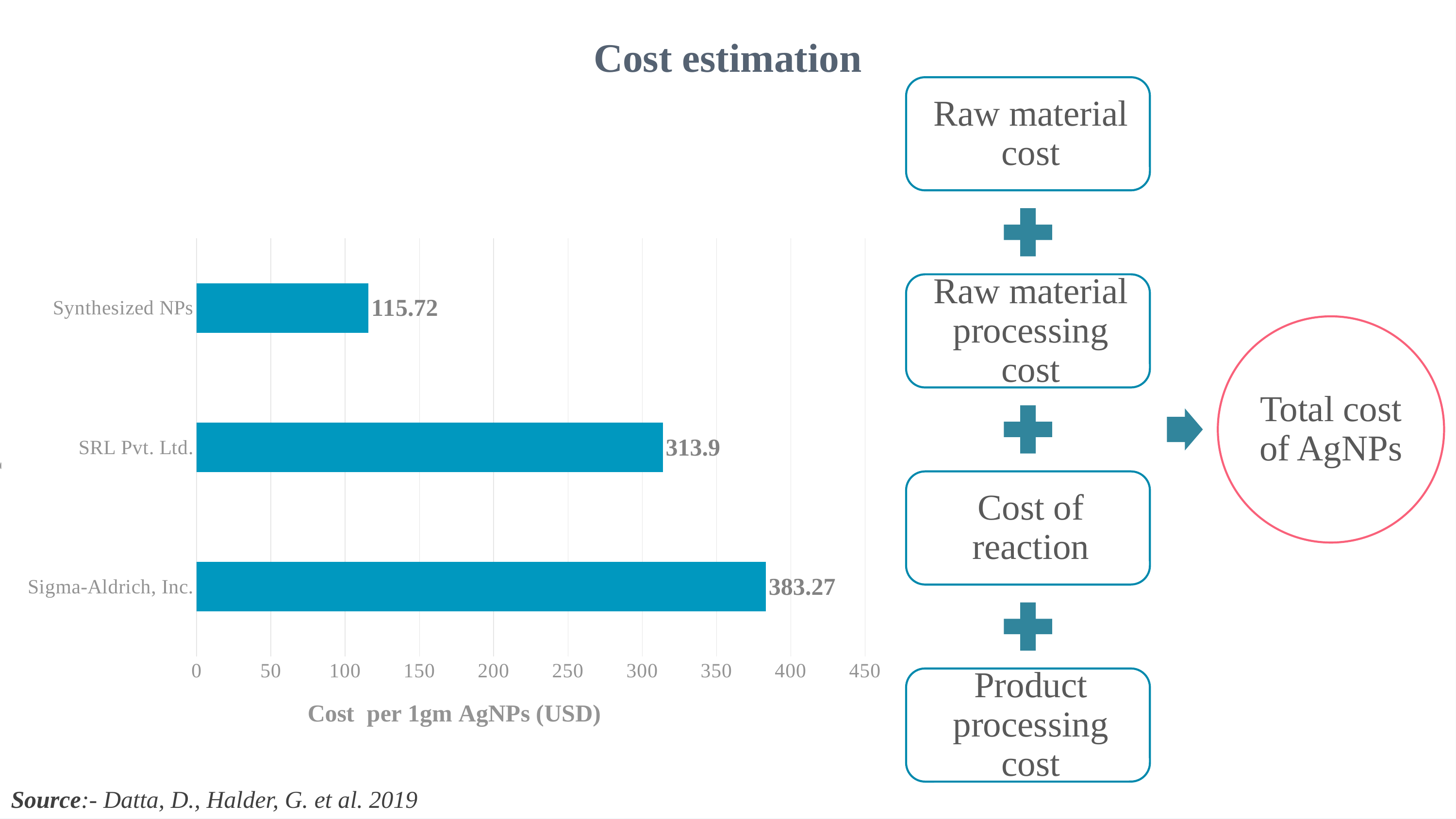
Which category has the lowest cost per 1gm AgNPs? Synthesized NPs What kind of chart is shown on the slide? Bar chart How many categories are shown in the chart? 3 What is the cost per 1gm AgNPs for Synthesized NPs? 115.72 Which category has the highest cost per 1gm AgNPs? Sigma-Aldrich, Inc. Is the value for SRL Pvt. Ltd. greater or less than 300? greater What is the cost per 1gm AgNPs for Sigma-Aldrich, Inc.? 383.27 What is the cost per 1gm AgNPs for SRL Pvt. Ltd.? 313.9 What is the difference in cost per 1gm AgNPs between SRL Pvt. Ltd. and Synthesized NPs? 198.18 Which has a higher cost per 1gm AgNPs, SRL Pvt. Ltd. or Synthesized NPs? SRL Pvt. Ltd. What is the difference in cost per 1gm AgNPs between Sigma-Aldrich, Inc. and Synthesized NPs? 267.55 What is the x-axis title of the chart? Cost per 1gm AgNPs (USD)